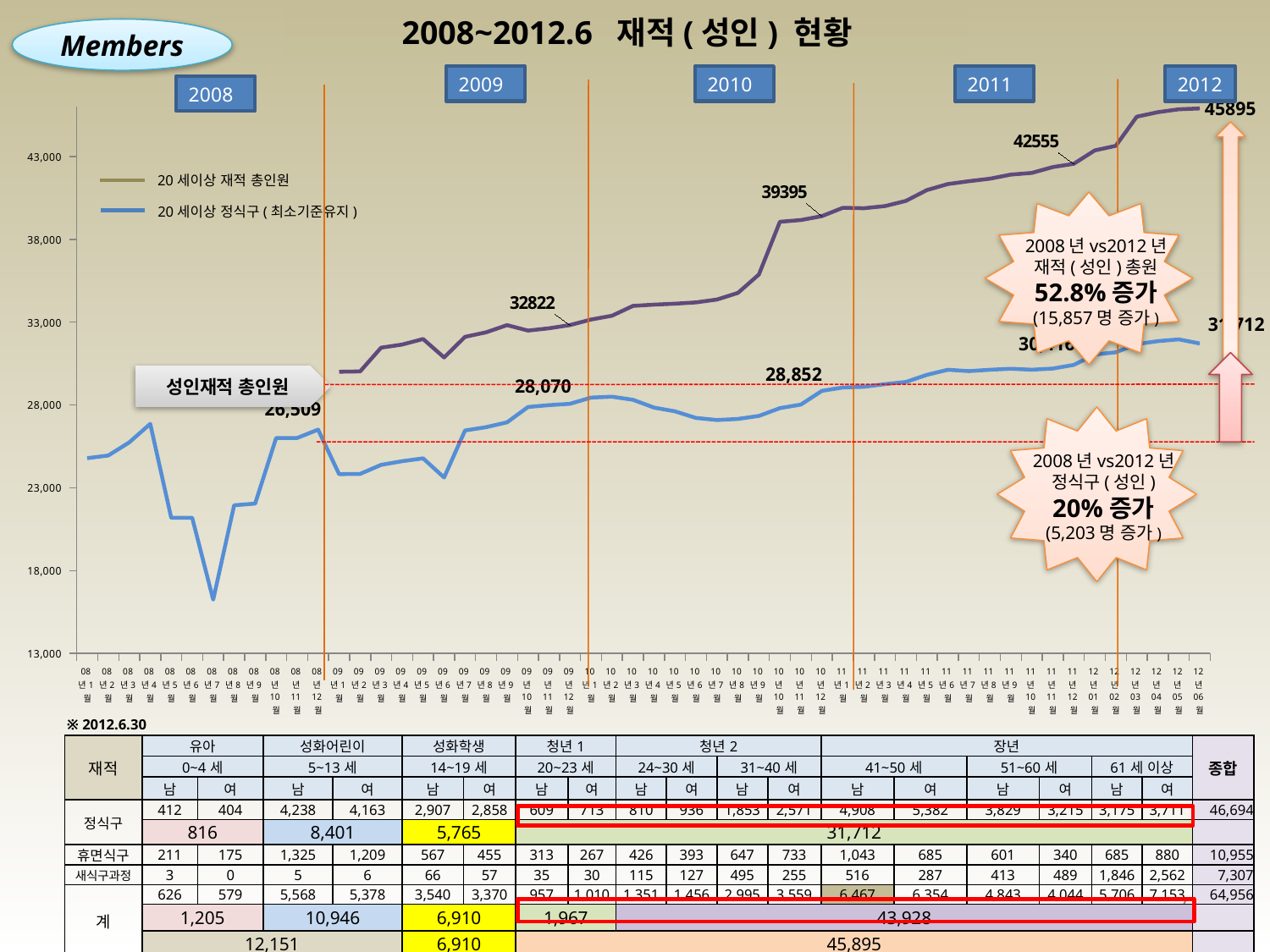
What kind of chart is shown on the slide? line chart Which line is higher at the right end of the chart, 20세이상 재적 총인원 or 20세이상 정식구? 20세이상 재적 총인원 Does the 20세이상 재적 총인원 line generally rise or fall from 2009 to 2012? rise What is the difference between the 2012 label (45895) and the 2011 label (42555) on the 20세이상 재적 총인원 line? 3340 What value is labeled on the 20세이상 재적 총인원 line in the 2009 section of the chart? 32822 How many series does the chart legend list? 2 What value is labeled on the 20세이상 정식구 line in the 2010 section of the chart? 28,852 What value is labeled on the 20세이상 재적 총인원 line in the 2010 section of the chart? 39395 Is the lowest point of the 20세이상 정식구 line in 2008 greater or less than 18,000? less What value is labeled on the 20세이상 재적 총인원 line in the 2011 section of the chart? 42555 What is the last labeled value on the 20세이상 재적 총인원 line, at the 2012 end of the chart? 45895 What value is labeled on the 20세이상 정식구 line in the 2009 section of the chart? 28,070